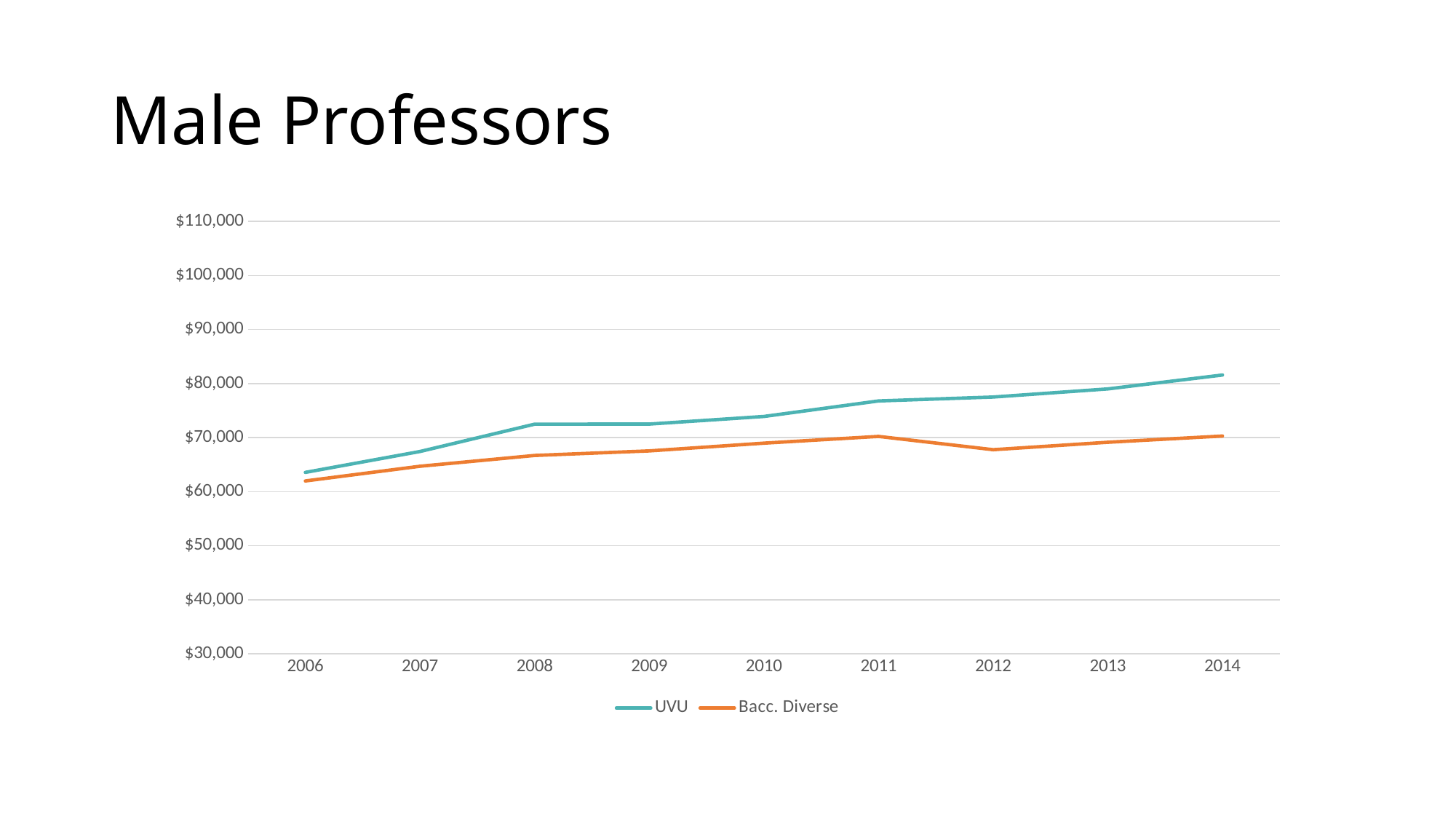
How many series does the legend list? 2 Is the Bacc. Diverse value for 2006 greater or less than $60,000? greater Is the Bacc. Diverse value for 2012 greater or less than $70,000? less Is the UVU value for 2006 greater or less than $70,000? less How many years are plotted along the x axis? 9 What kind of chart is shown on the slide? line chart What is the title of the slide containing the chart? Male Professors In which year is the UVU series at its highest? 2014 In 2014, which series has the higher value, UVU or Bacc. Diverse? UVU Which series is plotted in orange? Bacc. Diverse Does the UVU series generally rise or fall from 2006 to 2014? rise